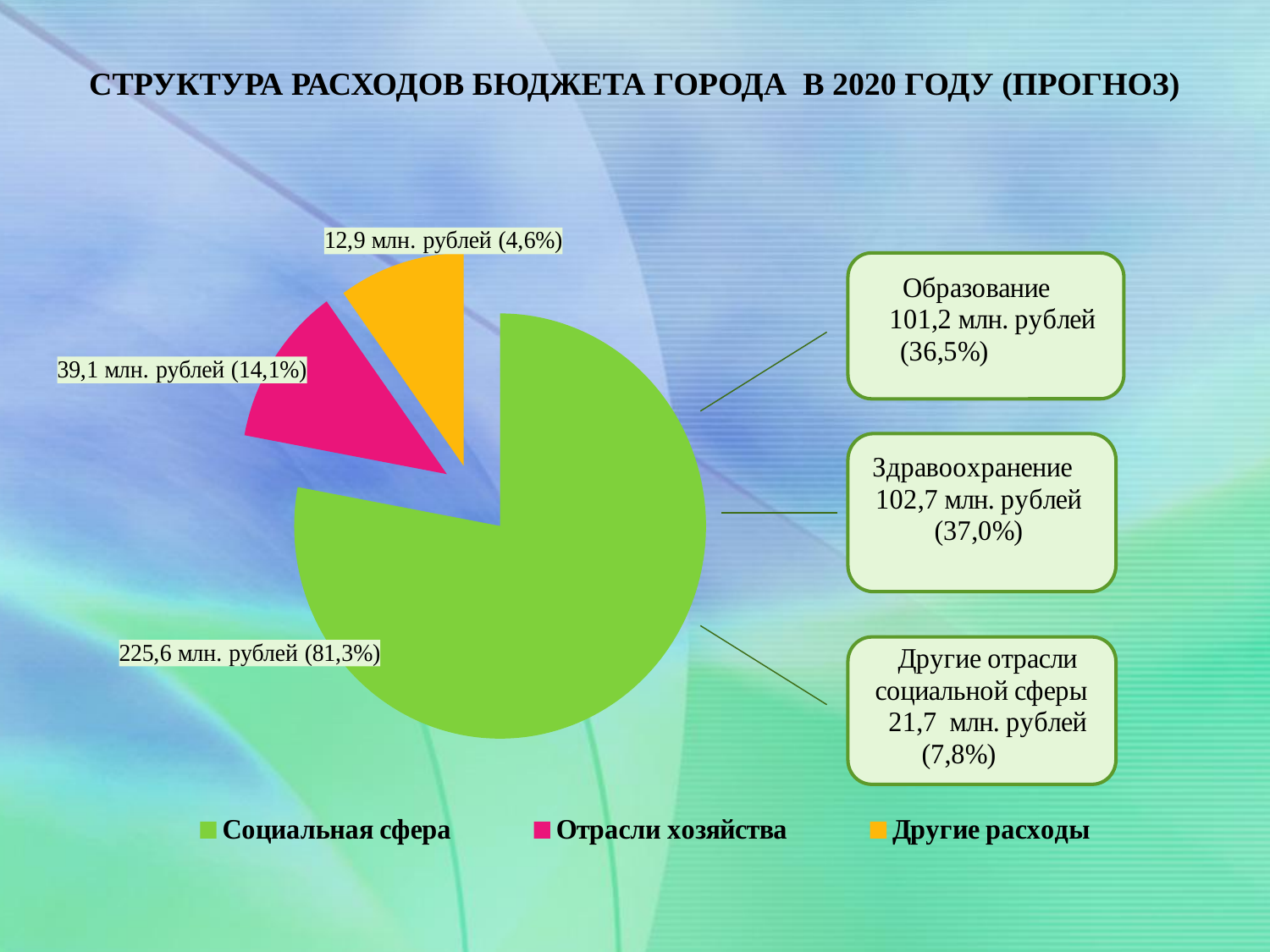
What share of the pie does Социальная сфера take? 81,3% Which colour represents Отрасли хозяйства in the pie chart? Pink (magenta) Which category has the smallest slice of the pie? Другие расходы How many slices does the pie chart have? 3 What is the value shown for Другие расходы? 12,9 млн. рублей What kind of chart is shown on the slide? Pie chart What is the value shown for Отрасли хозяйства? 39,1 млн. рублей What share of the pie does Другие расходы take? 4,6% What is the value shown for Социальная сфера? 225,6 млн. рублей How many entries does the legend list? 3 What is the difference in млн. рублей between Отрасли хозяйства and Другие расходы? 26,2 млн. рублей Which category has the largest slice of the pie? Социальная сфера